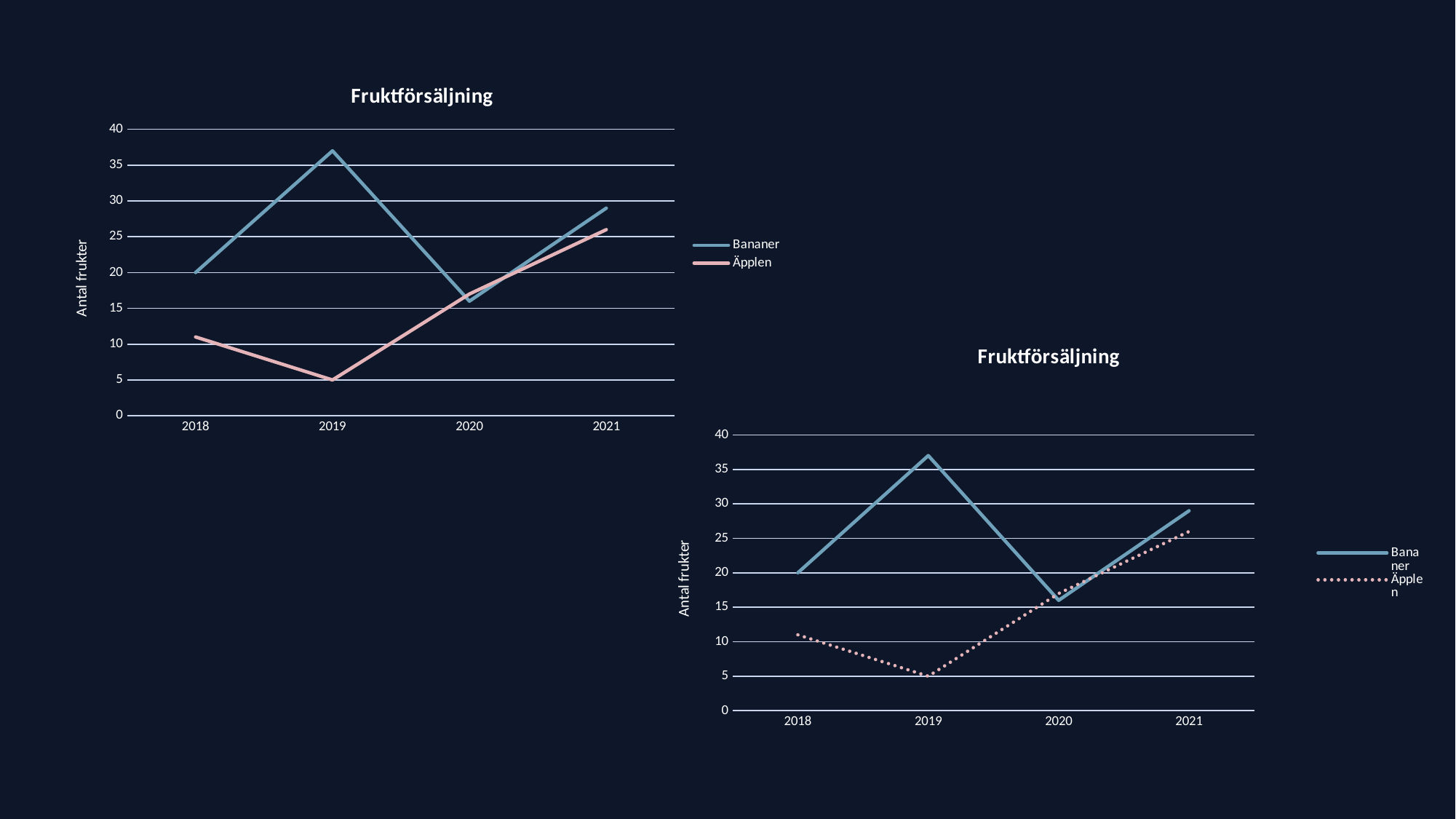
In the right chart, in which year is the Äpplen value lowest? 2019 In the left chart, which series has the larger value in 2019, Bananer or Äpplen? Bananer What is the y-axis title of the left chart? Antal frukter In the left chart, how many series does the legend list? 2 In the left chart, is the value for Bananer in 2019 greater or less than 35? greater What kind of chart is the left chart titled Fruktförsäljning? line chart In the left chart, what is the value for Bananer in 2018? 20 In the left chart, in which year is the Bananer value highest? 2019 In the right chart, do the Äpplen values rise or fall from 2019 to 2021? rise In the right chart, what is the value for Äpplen in 2019? 5 In the right chart, how many years are shown on the x axis? 4 In the right chart, is the value for Bananer in 2020 greater or less than 20? less